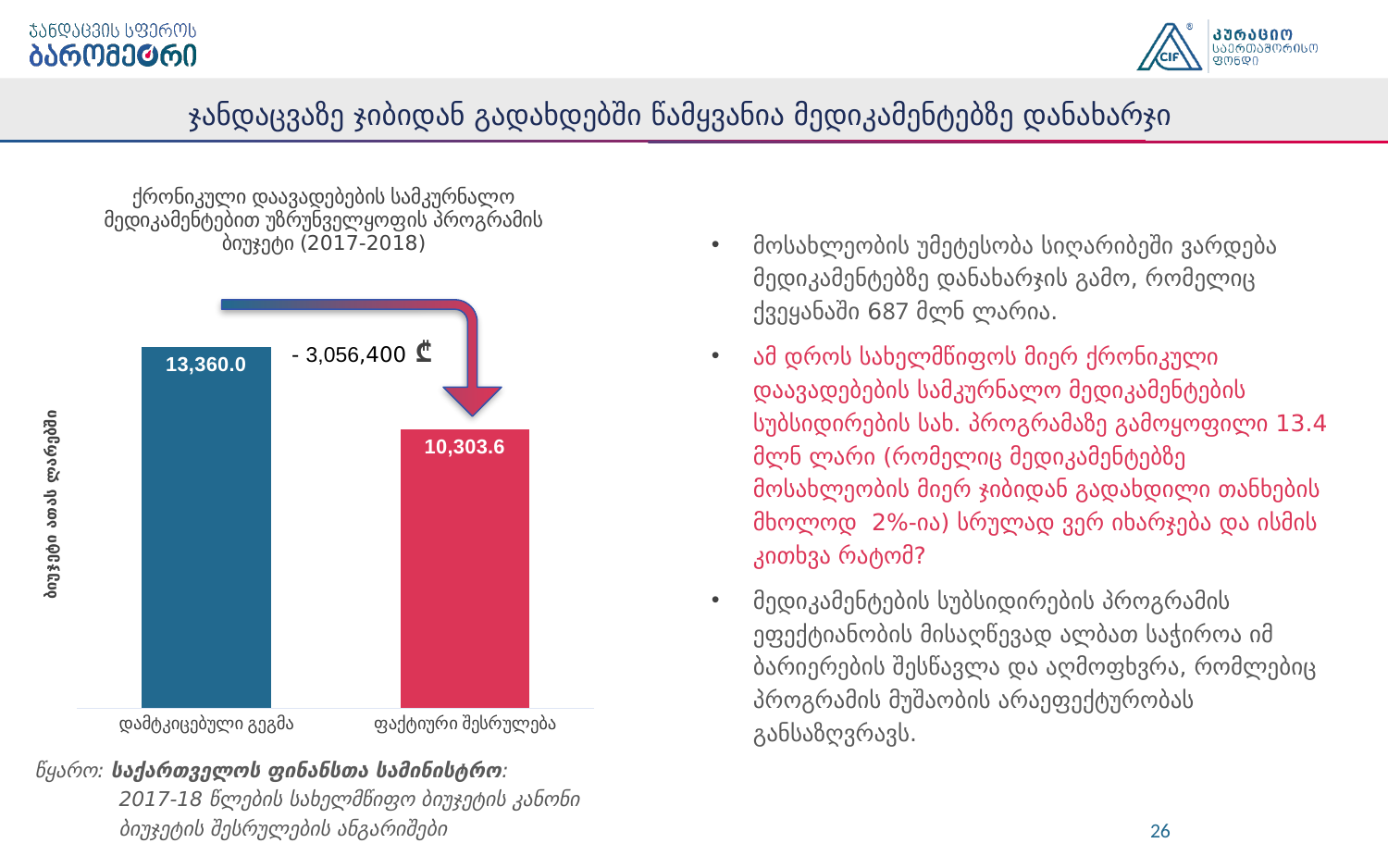
Which category has the higher value in the chart? დამტკიცებული გეგმა What is the value for დამტკიცებული გეგმა in the chart? 13,360.0 What amount is written next to the arrow annotation in the chart? - 3,056,400 ₾ What is the difference between the values for დამტკიცებული გეგმა and ფაქტიური შესრულება? 3,056.4 Do the values rise or fall from the left bar to the right bar? fall What is the label of the vertical axis of the chart? ბიუჯეტი ათას ლარებში What type of chart is shown on the slide? bar chart What is the value for ფაქტიური შესრულება in the chart? 10,303.6 How many bars are shown in the chart? 2 Is the value for დამტკიცებული გეგმა larger or smaller than the value for ფაქტიური შესრულება? larger Which category has the lower value in the chart? ფაქტიური შესრულება